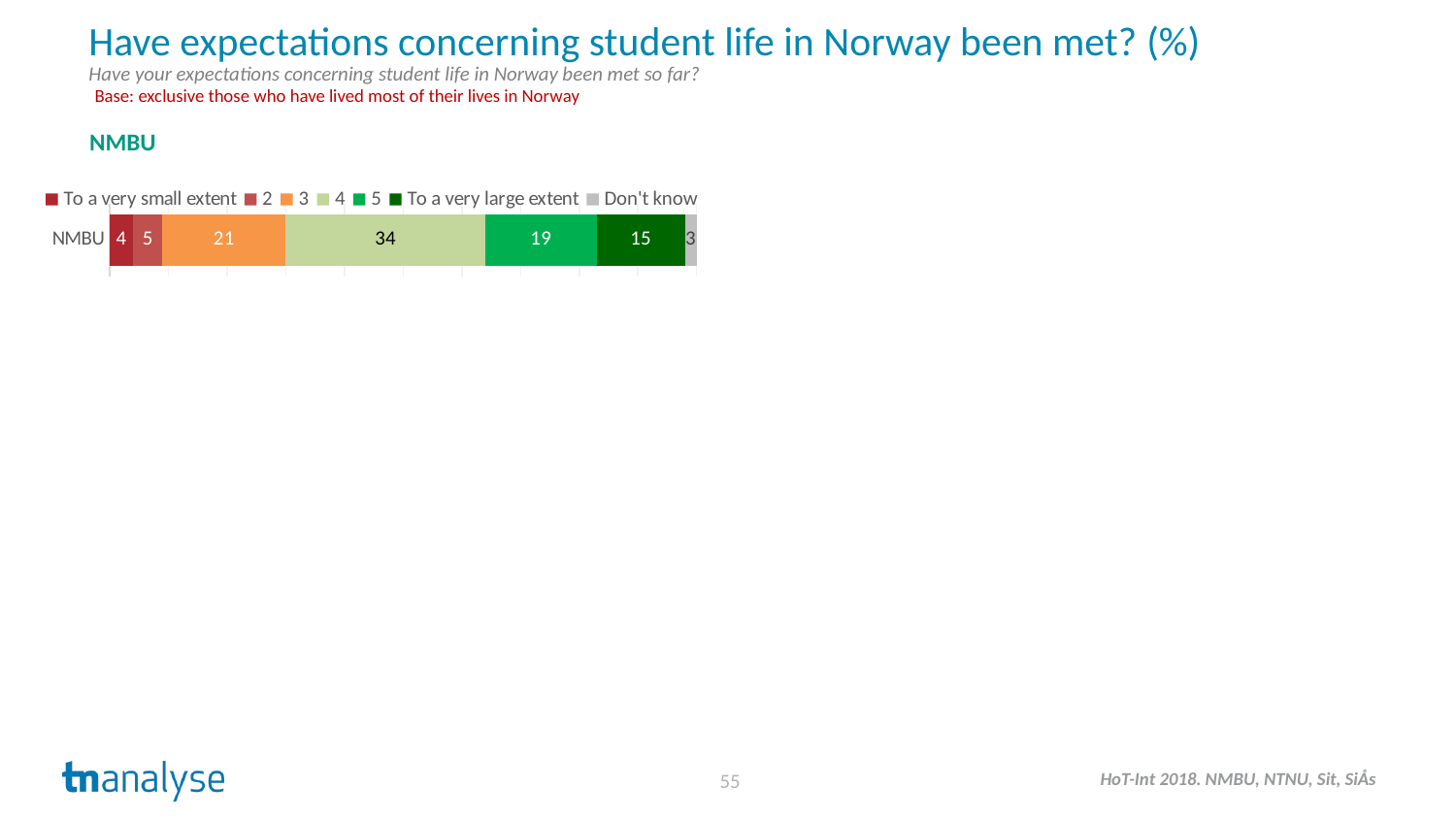
What is the value for "Don't know" in the NMBU bar? 3 Which response category has the largest value in the NMBU bar? 4 Which is larger in the NMBU bar, the value for "5" or the value for "To a very large extent"? 5 What is the value for "To a very small extent" in the NMBU bar? 4 Which response category has the smallest value in the NMBU bar? Don't know What is the total of all segments in the NMBU bar? 101 What kind of chart is shown on the slide? Stacked bar chart What is the difference between the values for "4" and "3" in the NMBU bar? 13 How many series does the legend list? 7 What is the difference between the values for "2" and "To a very small extent" in the NMBU bar? 1 What is the value for "To a very large extent" in the NMBU bar? 15 What is the value for "4" in the NMBU bar? 34